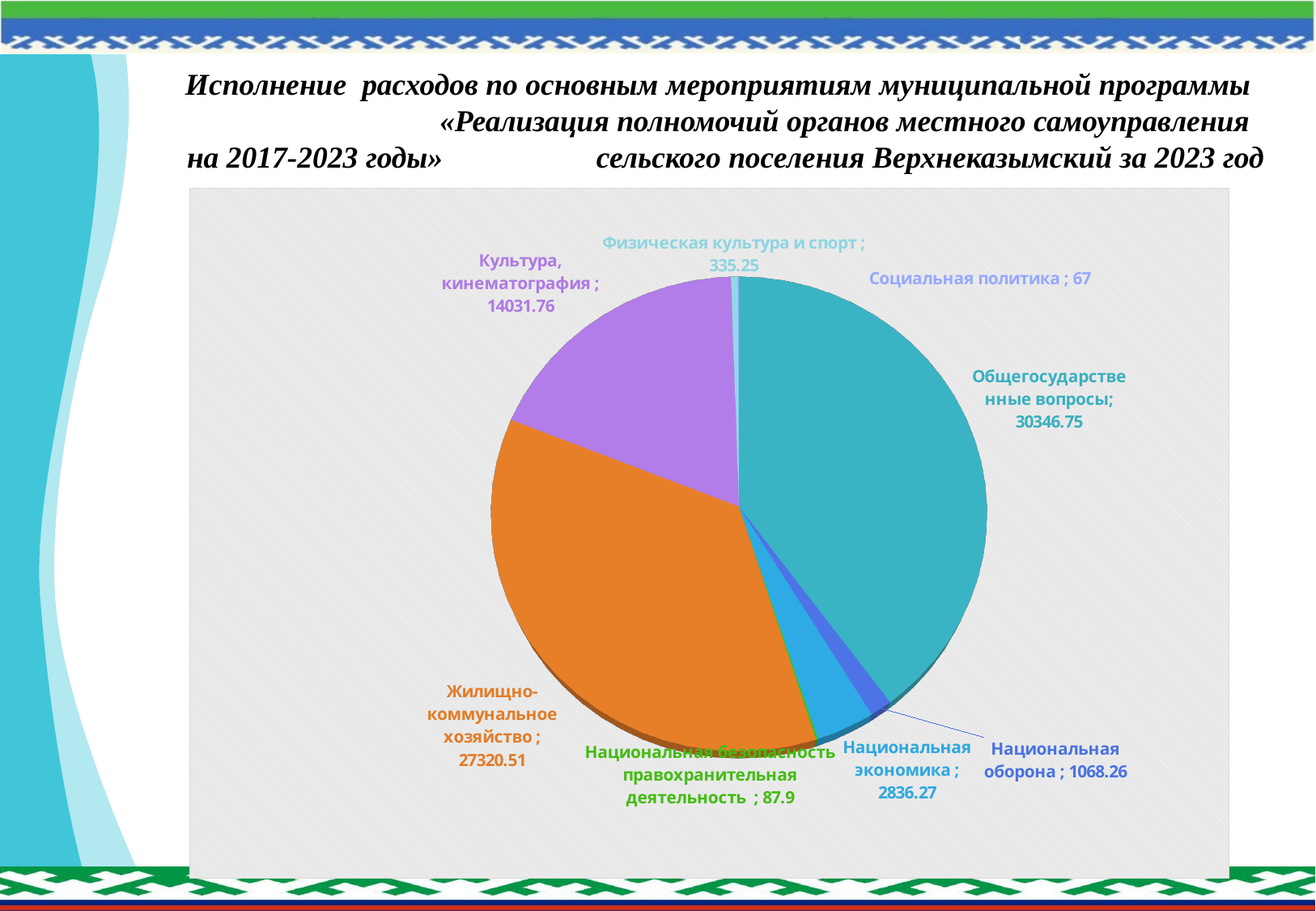
Which category has the largest value in the pie chart? Общегосударственные вопросы What is the value for Социальная политика? 67 What is the value for Национальная оборона? 1068.26 Which is larger: the value for Национальная экономика or the value for Национальная оборона? Национальная экономика What is the value for Культура, кинематография? 14031.76 What is the value for Общегосударственные вопросы? 30346.75 What is the difference between the values for Общегосударственные вопросы and Жилищно-коммунальное хозяйство? 3026.24 What type of chart is shown on the slide? Pie chart What is the difference between the values for Физическая культура и спорт and Социальная политика? 268.25 Which category has the smallest value in the pie chart? Социальная политика What is the value for Жилищно-коммунальное хозяйство? 27320.51 How many categories (slices) does the pie chart show? 8